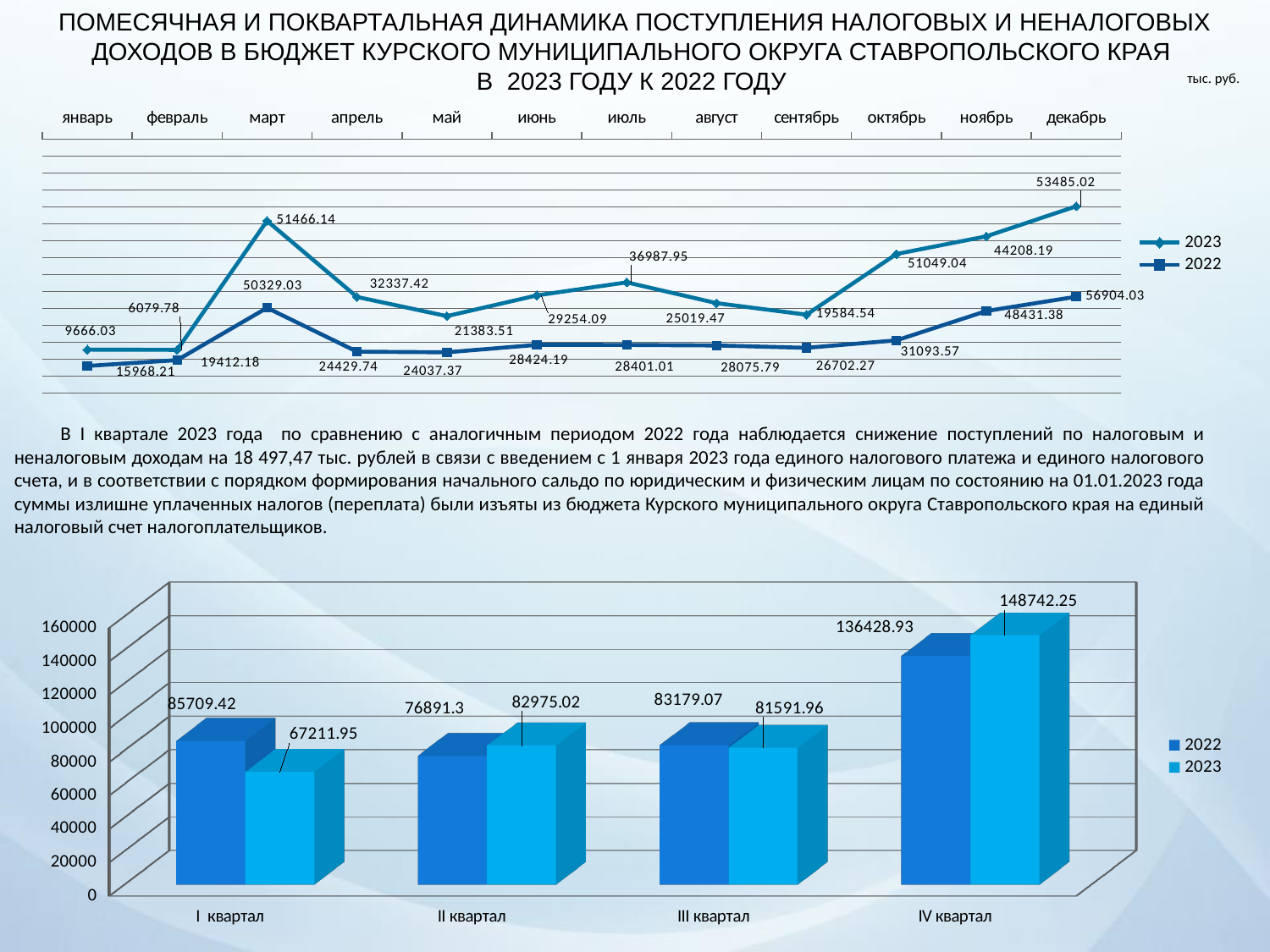
On the top line chart, what is the value for 2023 in март? 51466.14 On the top line chart, which month has the highest value for the 2022 series? декабрь On the bottom bar chart, which quarter has the highest value for 2022? IV квартал On the bottom bar chart, is the 2022 value for IV квартал greater or less than 120000? greater On the top line chart, how many months are plotted along the x axis? 12 On the top line chart, which month has the lowest value for the 2023 series? февраль What kind of chart is the bottom chart on the slide? bar chart On the top line chart, how many series does the legend list? 2 On the top line chart, which is larger in сентябрь: the 2023 value or the 2022 value? 2022 On the bottom bar chart, what is the value for 2023 in IV квартал? 148742.25 On the bottom bar chart, what is the difference between the 2022 and 2023 values in I квартал? 18497.47 On the top line chart, what is the value for 2022 in декабрь? 56904.03